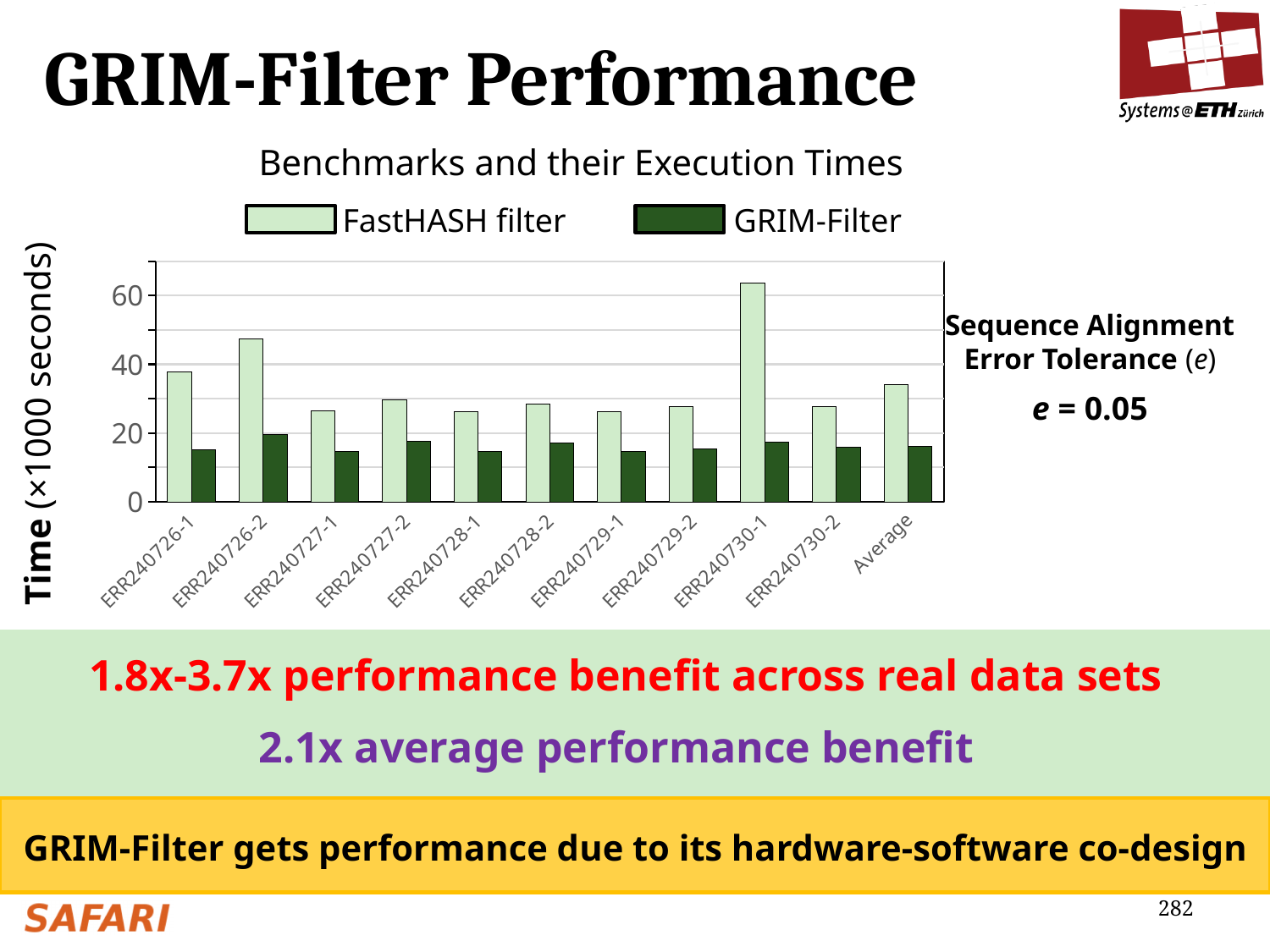
Which has the larger FastHASH filter value, ERR240726-1 or ERR240726-2? ERR240726-2 How many categories are shown along the x axis of the chart? 11 Is the FastHASH filter value for ERR240726-1 greater or less than 40? less Is the FastHASH filter value for ERR240730-1 greater or less than 60? greater How many series does the chart's legend list? 2 Which category has the highest FastHASH filter value? ERR240730-1 What kind of chart is shown on the slide? bar chart Is the GRIM-Filter value for ERR240726-1 greater or less than 20? less What is the label of the y axis of the chart? Time (×1000 seconds) For the Average category, which series has the larger value, FastHASH filter or GRIM-Filter? FastHASH filter What is the title of the chart? Benchmarks and their Execution Times